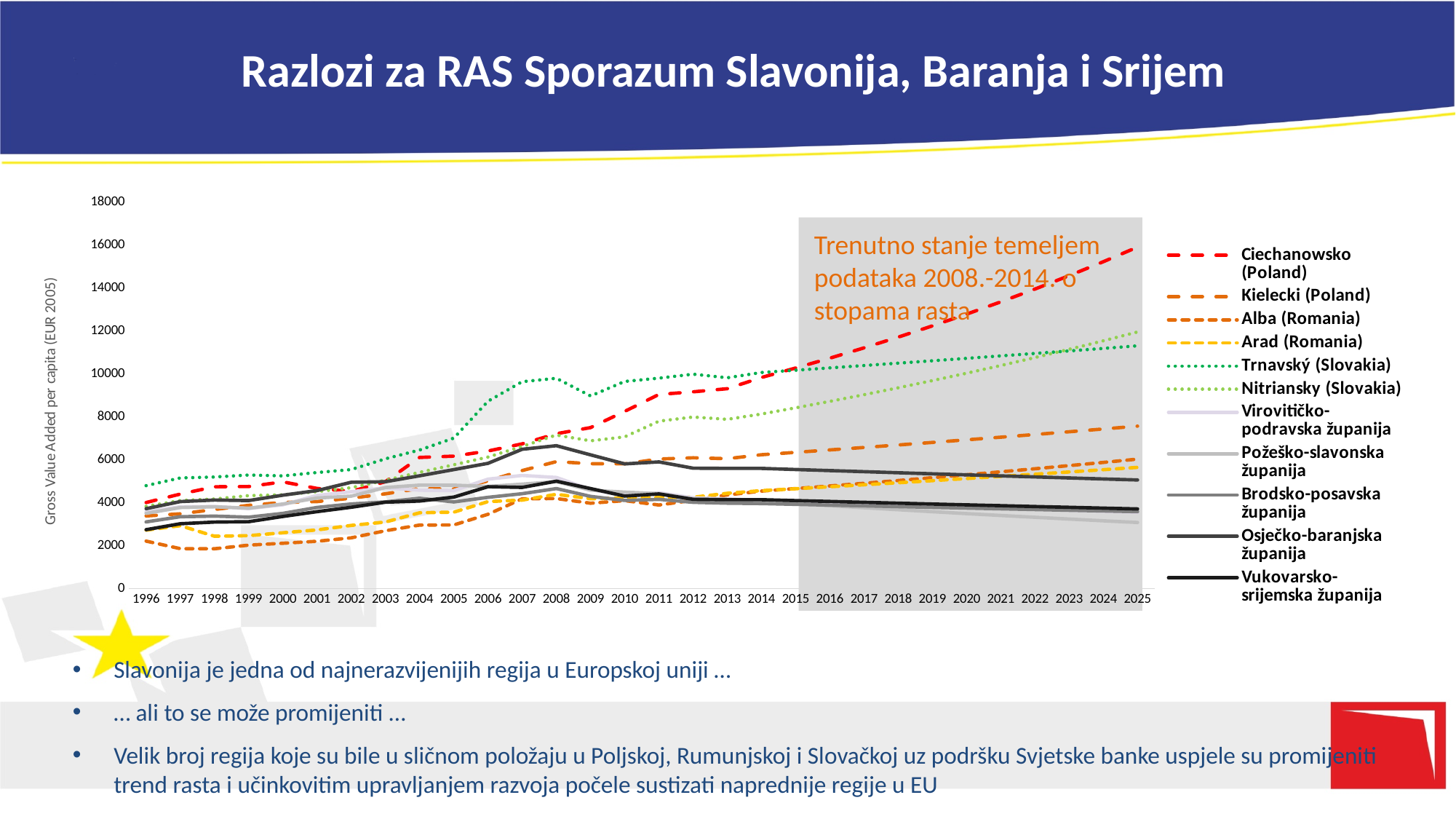
Is the value for Trnavský (Slovakia) in 2025 greater or less than 10000? greater Is the value for Ciechanowsko (Poland) in 2025 greater or less than 14000? greater How many years are shown on the x axis of the chart? 30 Does the value for Ciechanowsko (Poland) rise or fall overall from 1996 to 2025? rise Which series has the highest value in 2025? Ciechanowsko (Poland) What kind of chart is shown on the slide? line chart What is the first year shown on the x axis of the chart? 1996 Is the value for Vukovarsko-srijemska županija in 2025 greater or less than 4000? less How many series does the legend of the chart list? 11 What is the label of the vertical axis of the chart? Gross Value Added per capita (EUR 2005)